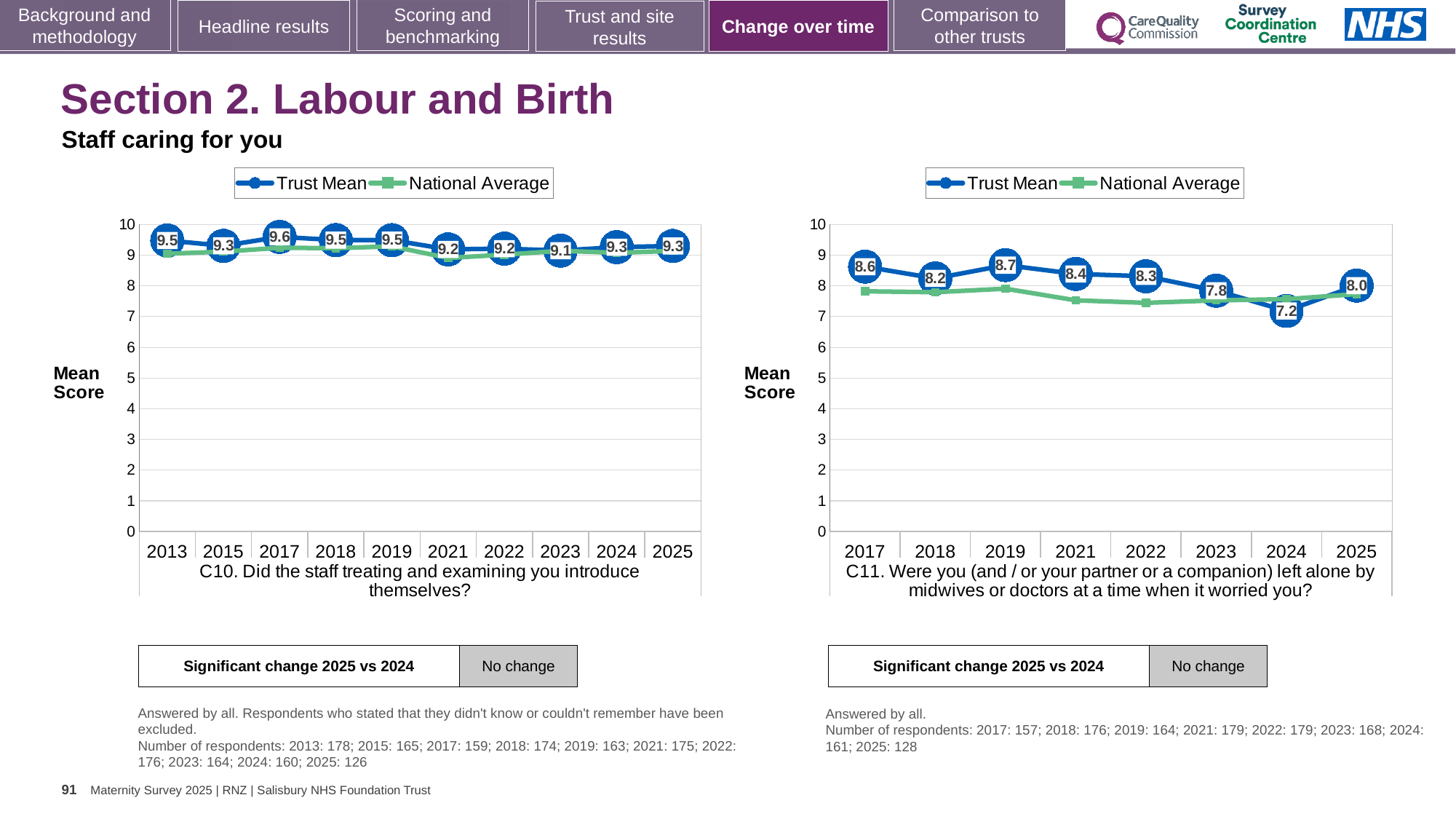
In the C11 chart (right), what is the difference between the Trust Mean scores for 2025 and 2024? 0.8 In the C11 chart (right), which year has the highest Trust Mean score? 2019 How many series does the legend of the C11 chart (right) list? 2 In the C11 chart (right), what is the Trust Mean score for 2024? 7.2 In the C10 chart (left), what is the difference between the Trust Mean scores for 2017 and 2023? 0.5 In the C11 chart (right), which year has the lowest Trust Mean score? 2024 In the C10 chart (left), which year has the highest Trust Mean score? 2017 In the C10 chart (left), which year has the lowest Trust Mean score? 2023 In the C11 chart (right), is the National Average value for 2017 greater or less than 7? greater In the C10 chart (left), how many years are shown on the x axis? 10 In the C11 chart (right), is the Trust Mean score for 2018 larger or smaller than the score for 2019? smaller In the C10 chart (left), what is the Trust Mean score for 2025? 9.3